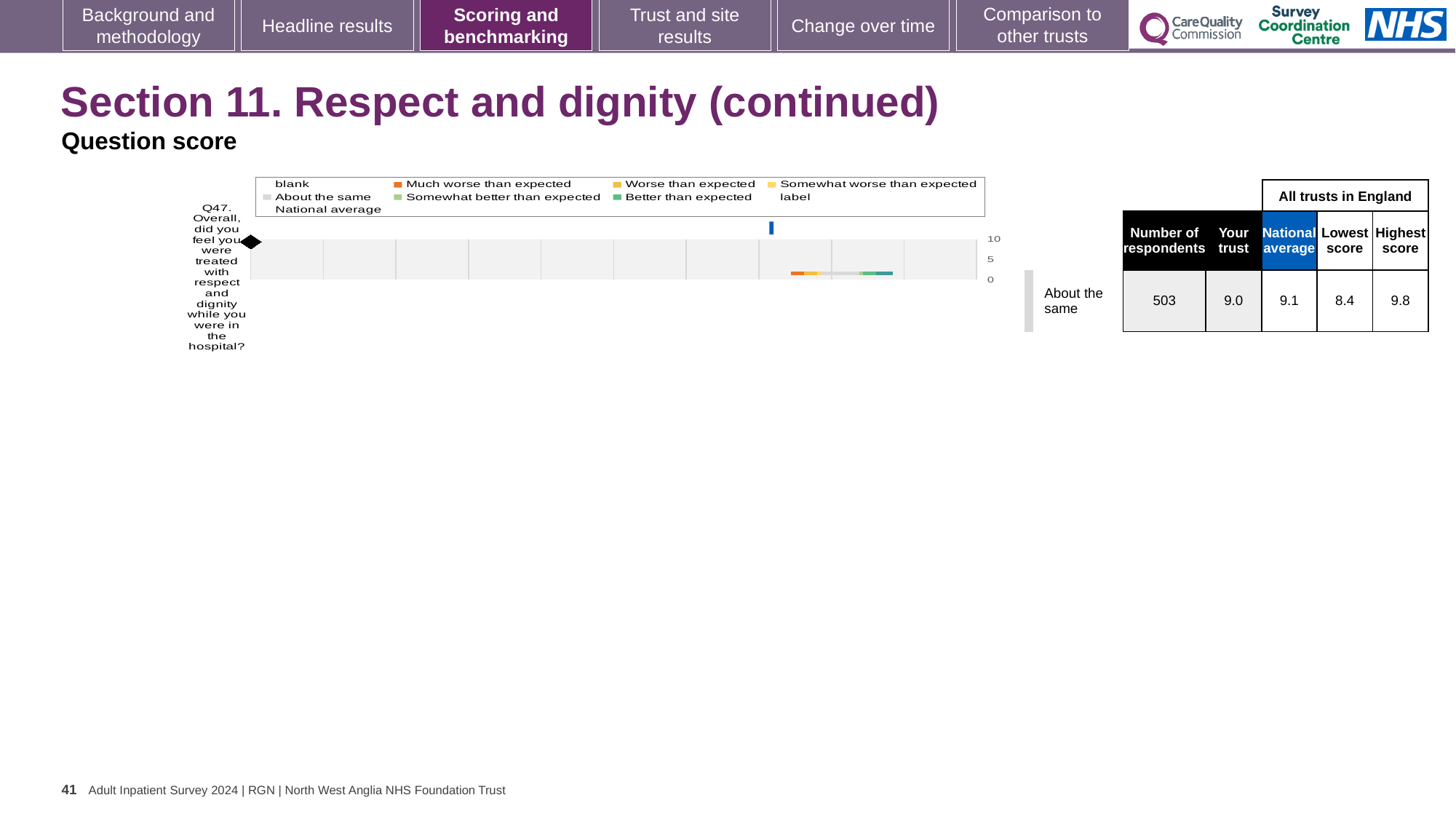
Which question number is plotted in the chart? Q47 What is the highest score among all trusts in England for Q47? 9.8 What is the national average score for Q47? 9.1 What is the 'Your trust' score for Q47? 9.0 How many questions are plotted in the chart? 1 What benchmark category is Q47 rated as on the slide? About the same Which legend entry is shown in orange? Much worse than expected What is the highest tick value shown on the chart's axis? 10 Which is larger for Q47, the trust score or the national average? national average What is the number of respondents for Q47? 503 What kind of chart is shown on the slide? bar chart What is the lowest score among all trusts in England for Q47? 8.4